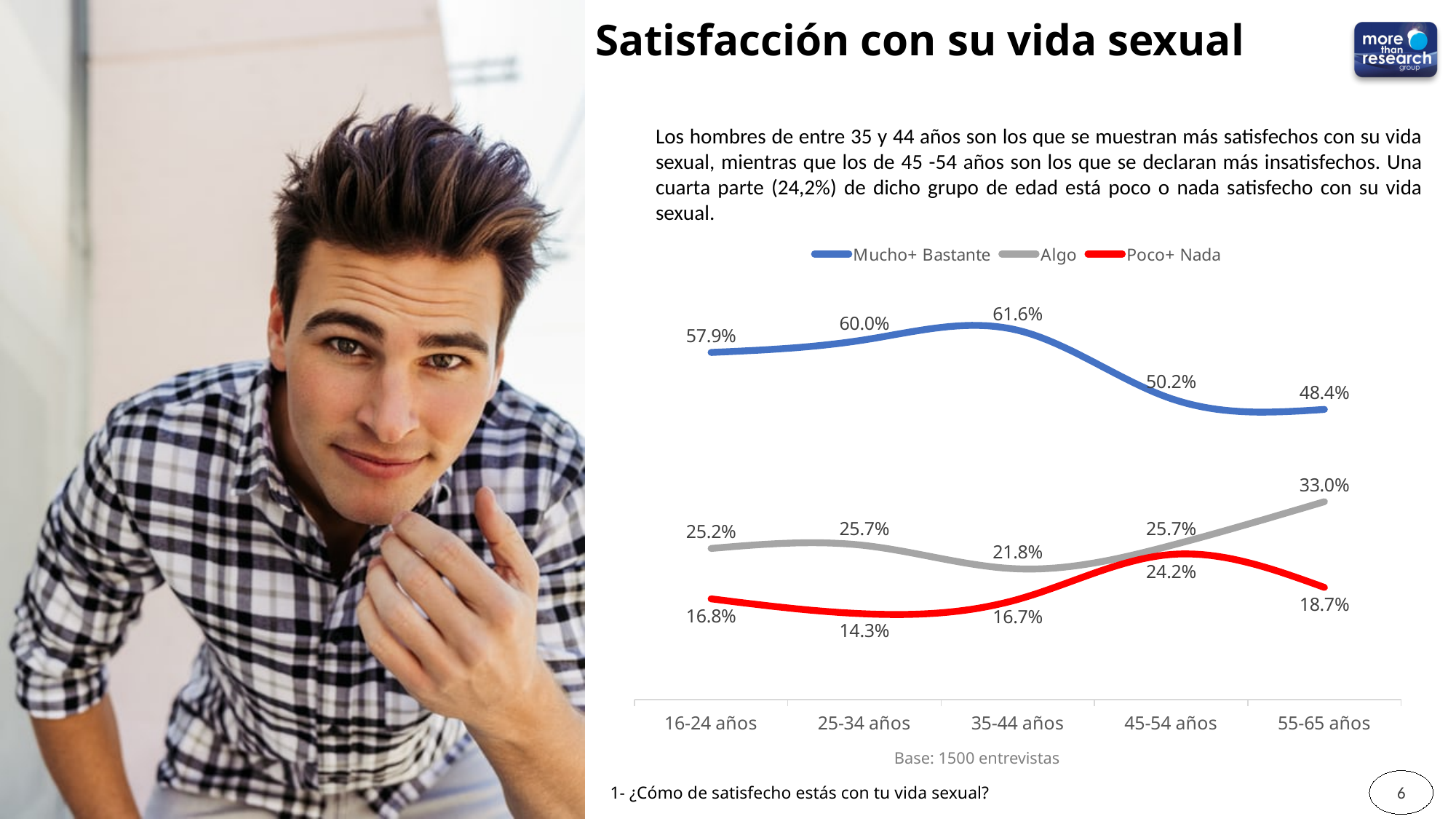
What type of chart is shown on the slide? Line chart What is the difference between the Mucho+ Bastante values for 35-44 años and 55-65 años? 13.2% How many age groups are shown on the x axis? 5 What colour is the line for Poco+ Nada? Red What is the value of Mucho+ Bastante for 35-44 años? 61.6% How many series does the legend list? 3 Does the Mucho+ Bastante series rise or fall from 35-44 años to 55-65 años? Fall For 45-54 años, which is larger: Algo or Poco+ Nada? Algo What is the value of Poco+ Nada for 45-54 años? 24.2% Which age group has the highest value for Mucho+ Bastante? 35-44 años Which age group has the lowest value for Poco+ Nada? 25-34 años What is the value of Algo for 55-65 años? 33.0%